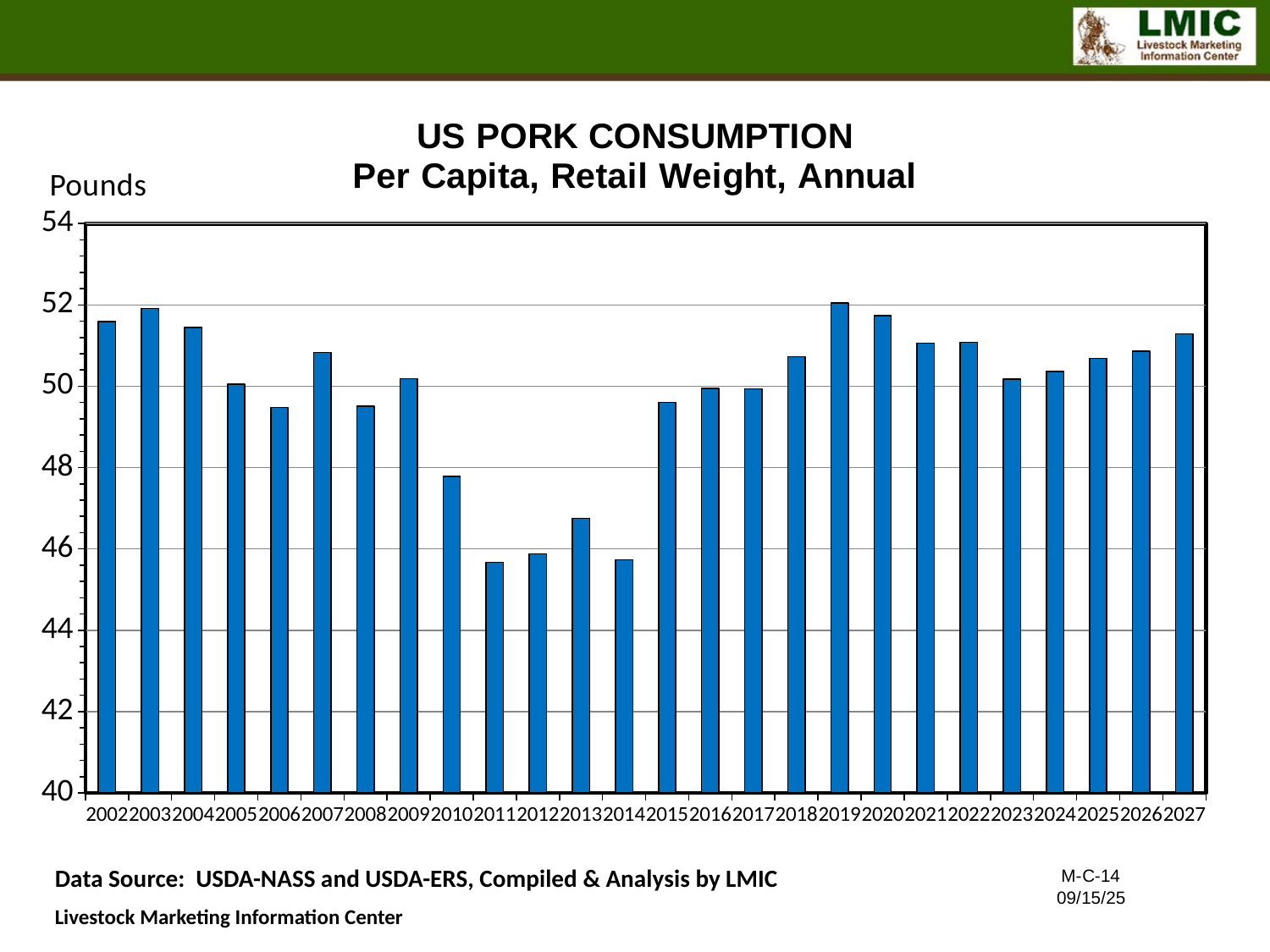
Is the value for 2013 greater or less than 46? greater Is the value for 2010 greater or less than 48? less What is the title of the chart? US PORK CONSUMPTION Per Capita, Retail Weight, Annual Do the values generally rise or fall from 2014 to 2019? rise What kind of chart is shown on the slide? bar chart Is the value for 2006 greater or less than 50? less How many years (bars) are plotted in the US Pork Consumption chart? 26 Which year has the larger value, 2013 or 2012? 2013 Which year has the larger value, 2010 or 2011? 2010 What unit is shown on the vertical axis of the chart? Pounds